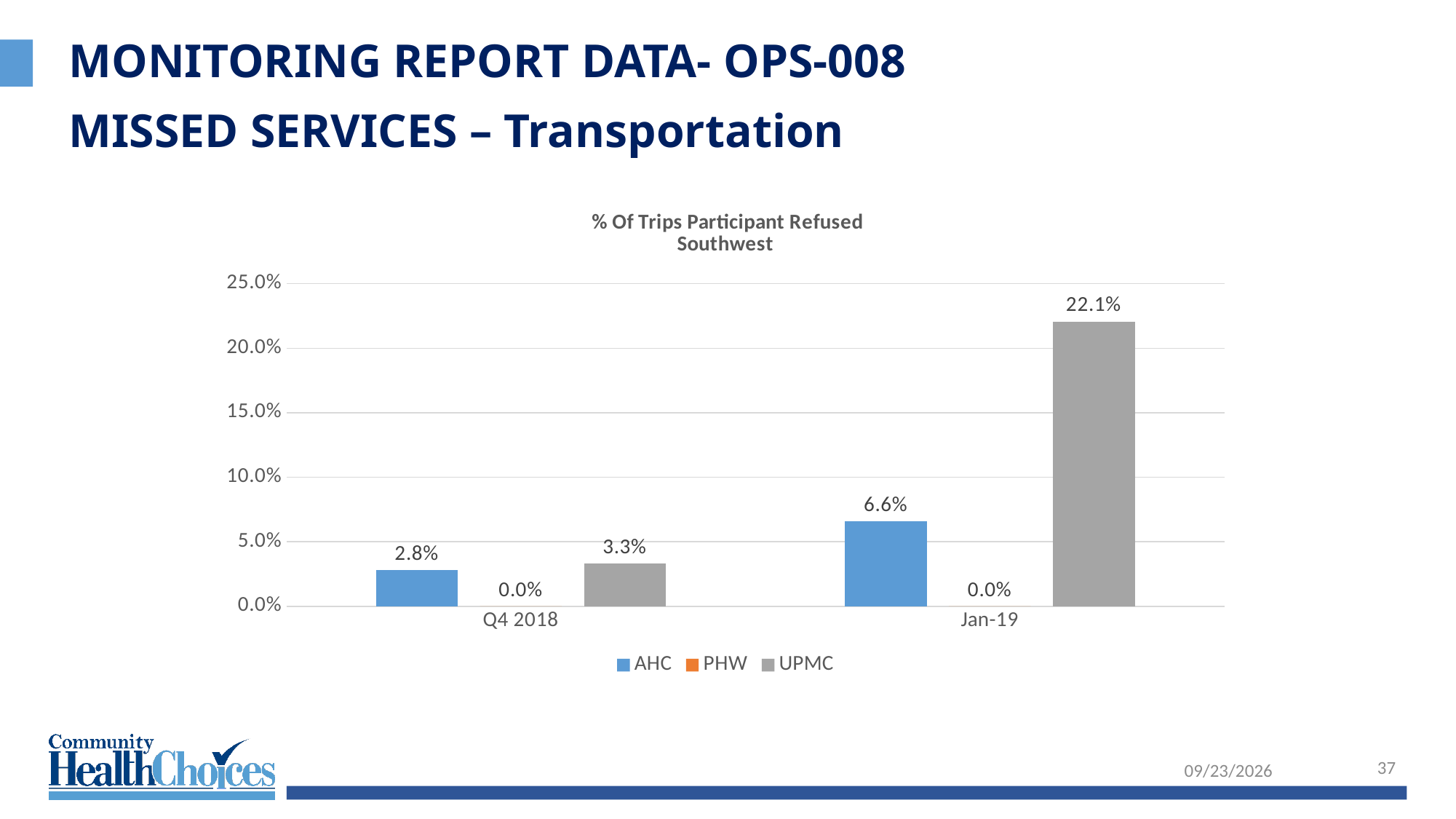
Which is larger, the AHC value in Jan-19 or the AHC value in Q4 2018? Jan-19 What is the value for UPMC in Jan-19? 22.1% How many periods are shown on the x axis? 2 How many series does the legend list? 3 What is the value for AHC in Q4 2018? 2.8% What is the value for PHW in Jan-19? 0.0% What is the value for UPMC in Q4 2018? 3.3% Which series has the highest value in Jan-19? UPMC Which series has the lowest value in Q4 2018? PHW Is the value for UPMC in Jan-19 greater or less than 20.0%? greater What kind of chart is shown on the slide? Bar chart What is the difference between the UPMC value in Jan-19 and the UPMC value in Q4 2018? 18.8%